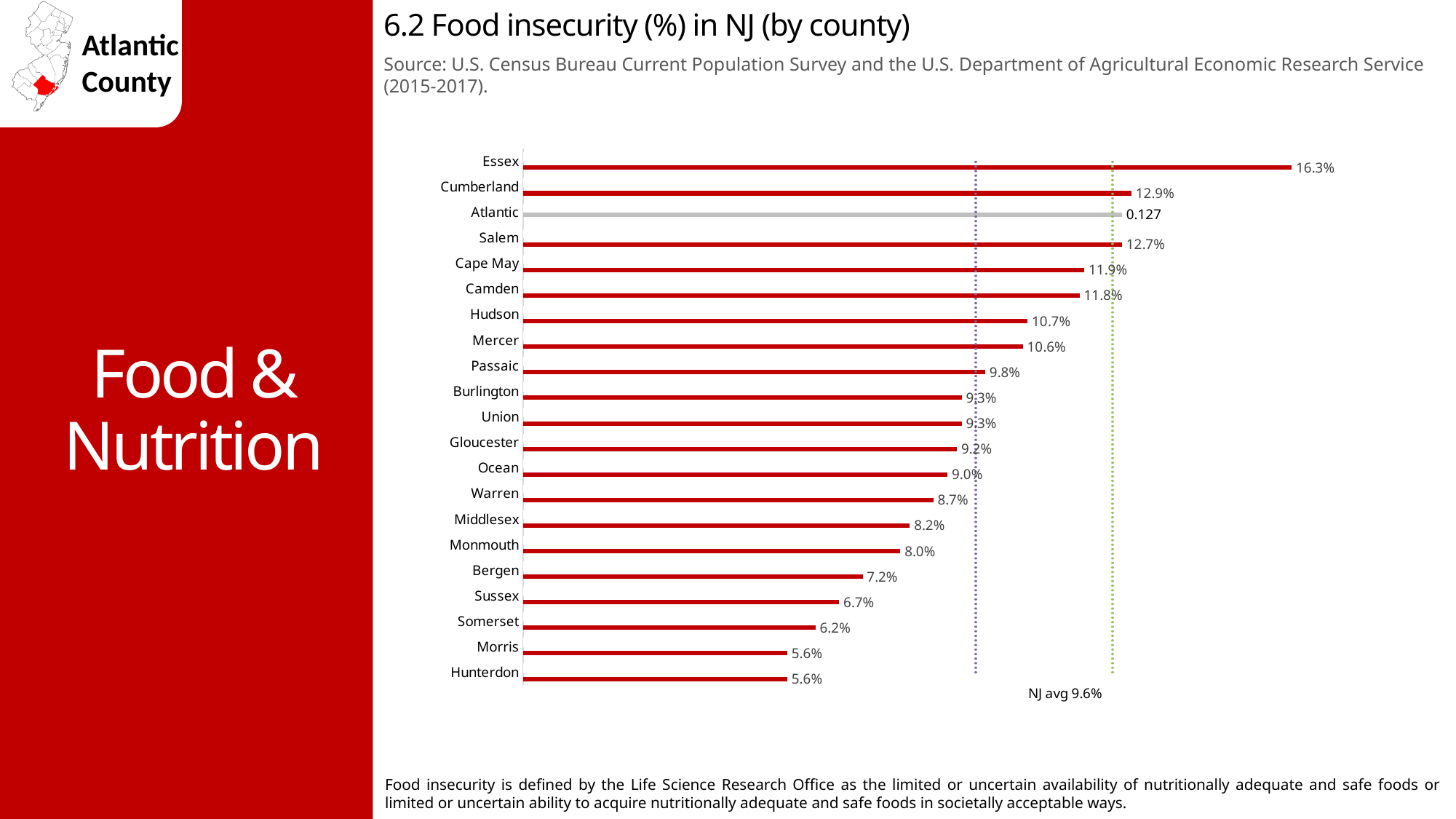
What is the difference between the food insecurity percentages of Essex and Cumberland? 3.4 percentage points What is the difference between the values for Camden and Monmouth? 3.8 percentage points Which county has the highest food insecurity percentage? Essex How many counties are shown in the chart? 21 What is the food insecurity percentage for Passaic? 9.8% What value is printed next to the Atlantic bar? 0.127 Which has a higher food insecurity percentage, Sussex or Somerset? Sussex Which has a higher food insecurity percentage, Hudson or Bergen? Hudson What is the food insecurity percentage for Bergen? 7.2% What NJ average value is labeled on the chart? 9.6% What is the food insecurity value shown for Salem? 12.7% What kind of chart is shown on the slide? Bar chart